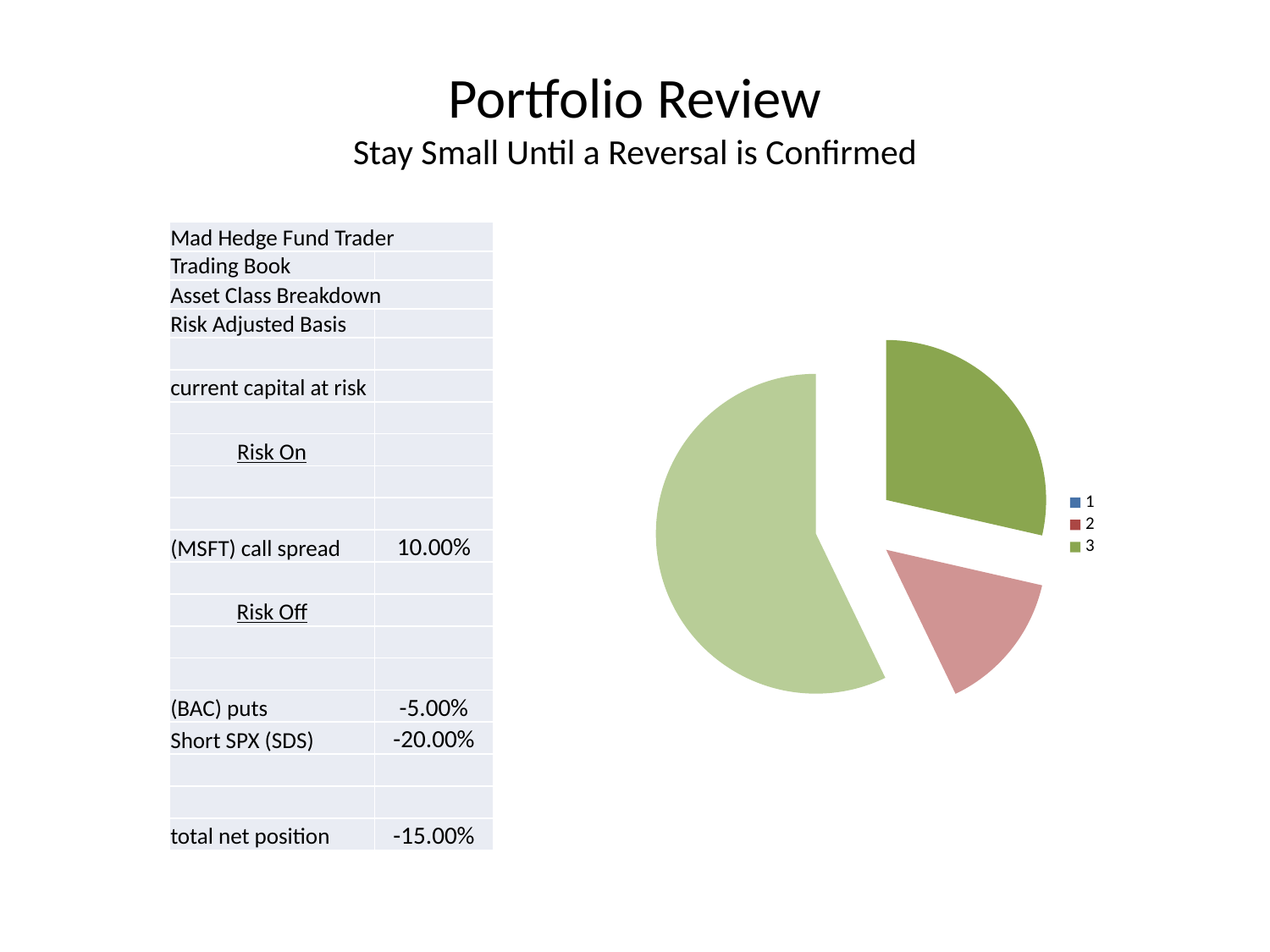
Does the largest slice of the pie chart take up more or less than half of the pie? more How many entries does the pie chart's legend list? 3 Are any of the pie chart's slices pulled out (exploded) from the centre of the pie? yes What kind of chart is shown on the slide? pie chart Is the smallest slice of the pie chart greater or less than 25% of the pie? less How many slices does the pie chart have? 3 What are the entries listed in the pie chart's legend? 1, 2, 3